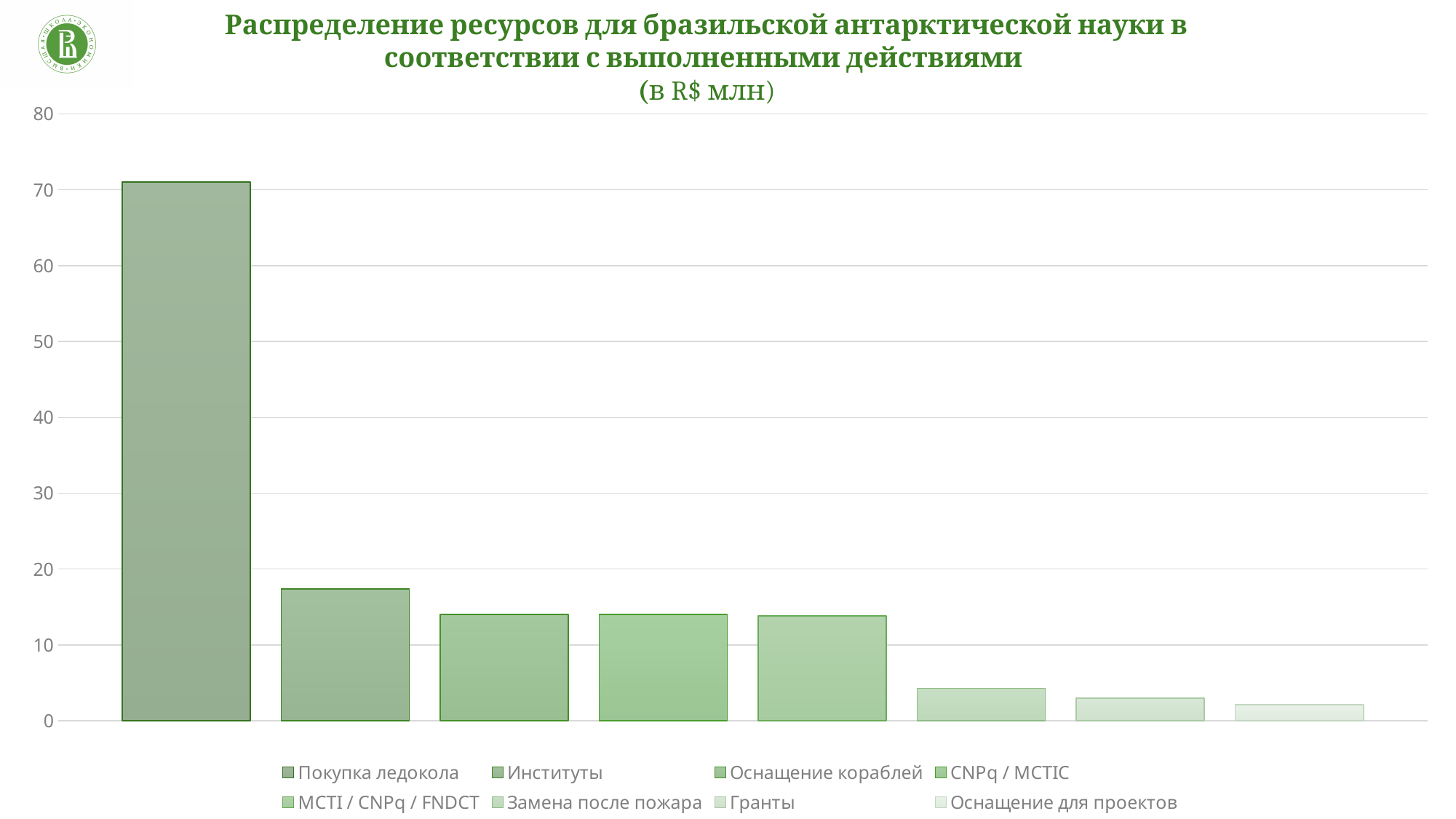
How many entries does the legend list? 8 In what units are the values on the chart expressed, according to the title? R$ млн Do the bar values rise or fall from left to right across the chart? fall Which category has the lowest value? Оснащение для проектов Is the value for Покупка ледокола greater or less than 70? greater Which is larger, the value for Покупка ледокола or the value for Институты? Покупка ледокола What kind of chart is shown on the slide? bar chart Which category has the highest value? Покупка ледокола Is the value for Институты greater or less than 20? less How many bars are plotted in the chart? 8 Is the value for Замена после пожара greater or less than 10? less